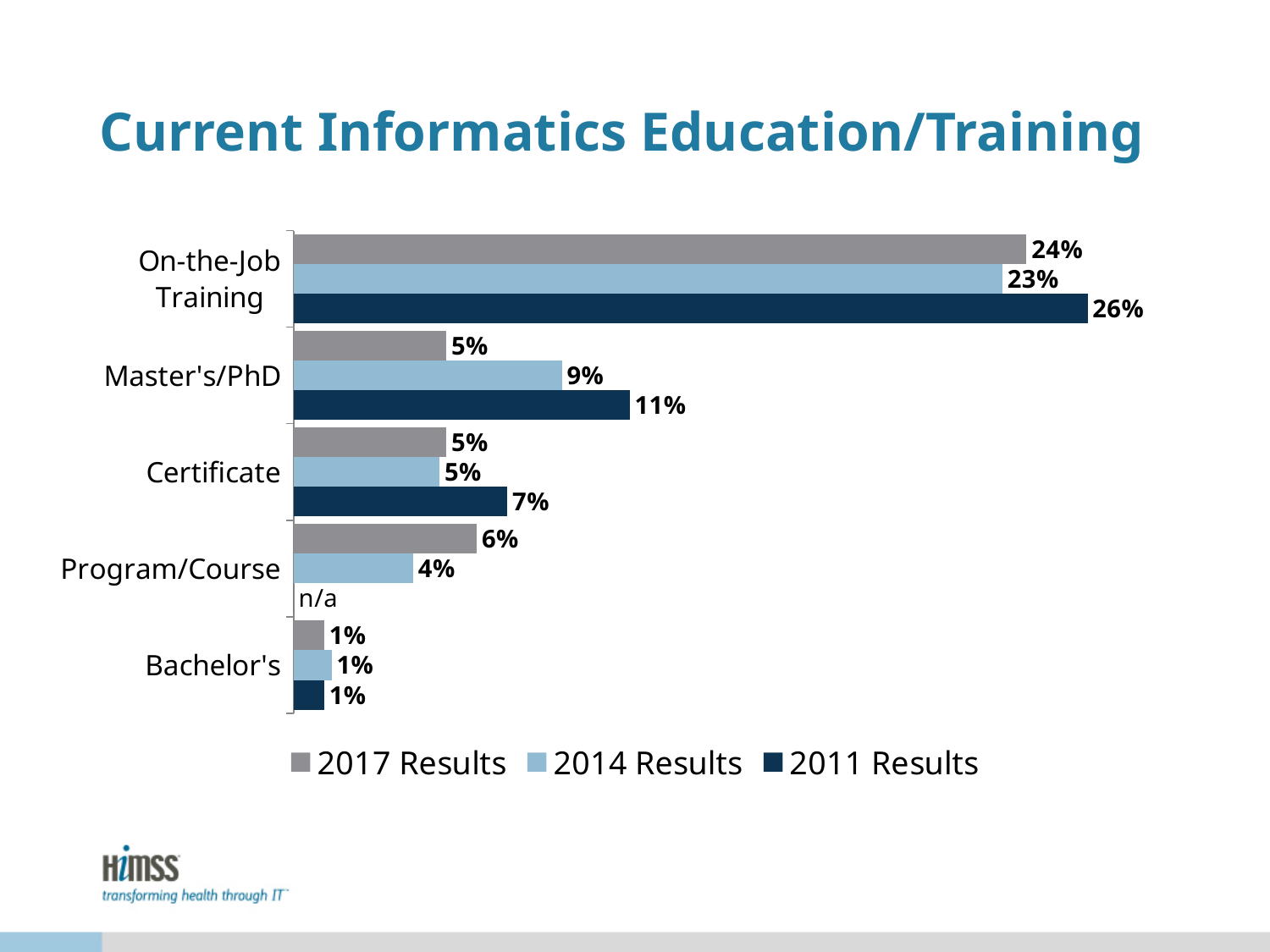
What is the difference between the 2011 Results and 2017 Results values for Master's/PhD? 6% What is the 2017 Results value for On-the-Job Training? 24% What is the title of the chart? Current Informatics Education/Training What kind of chart is shown on the slide? Bar chart What is the 2011 Results value for Master's/PhD? 11% What is shown for the 2011 Results value for Program/Course? n/a What is the 2014 Results value for Program/Course? 4% Which category has the lowest 2017 Results value? Bachelor's Which is larger for On-the-Job Training: the 2014 Results value or the 2011 Results value? 2011 Results How many series does the legend list? 3 How many categories are shown on the chart? 5 Which category has the highest 2011 Results value? On-the-Job Training